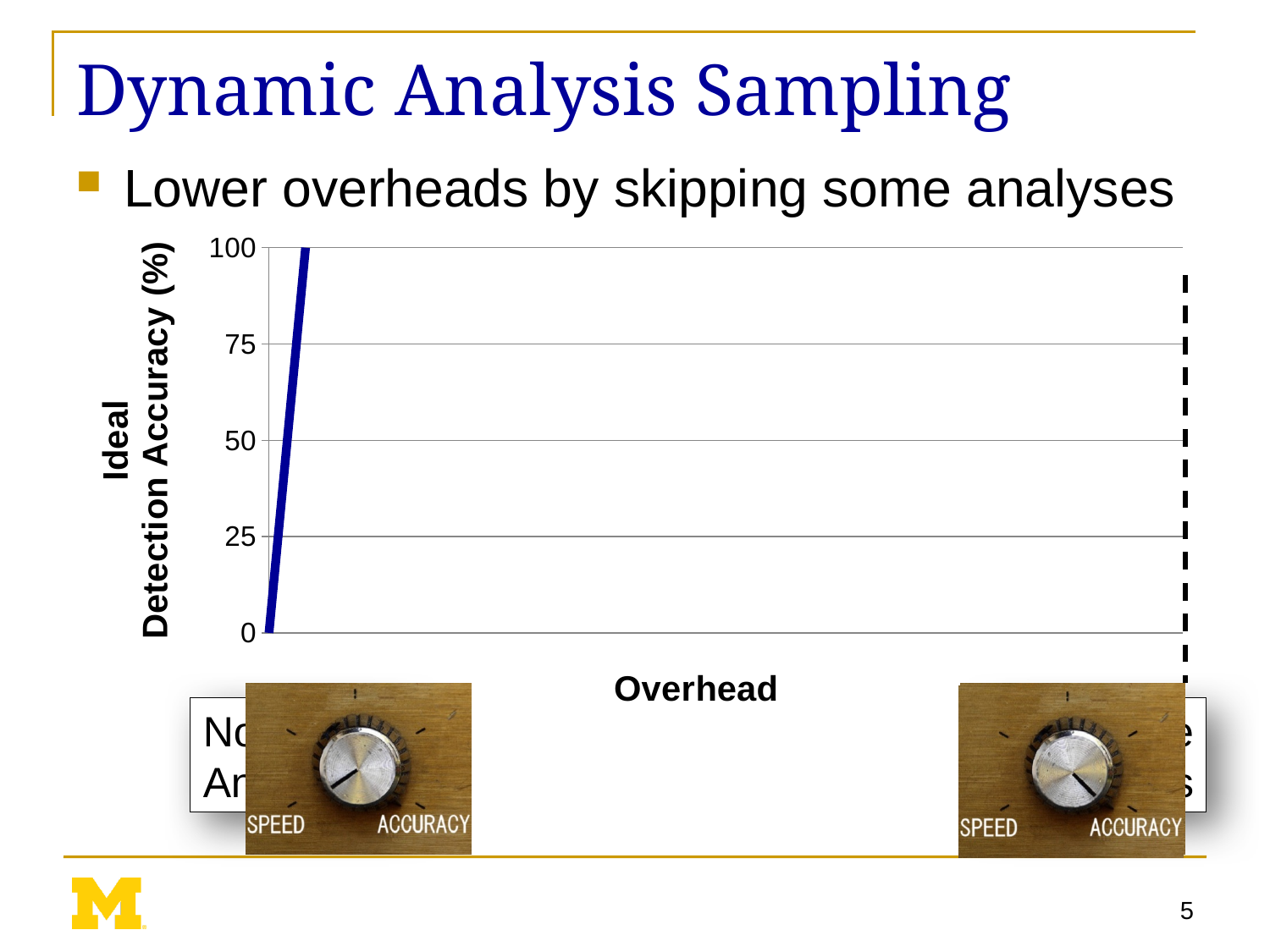
What is the highest tick value shown on the vertical axis? 100 Is the top of the plotted line greater or less than 75 on the vertical axis? greater Does the plotted line rise or fall as overhead increases along the x axis? rise What is the title of the vertical axis of the chart? Detection Accuracy (%) What is the title of the horizontal axis of the chart? Overhead How many tick labels are shown on the vertical axis? 5 What kind of chart is shown on the slide? line chart